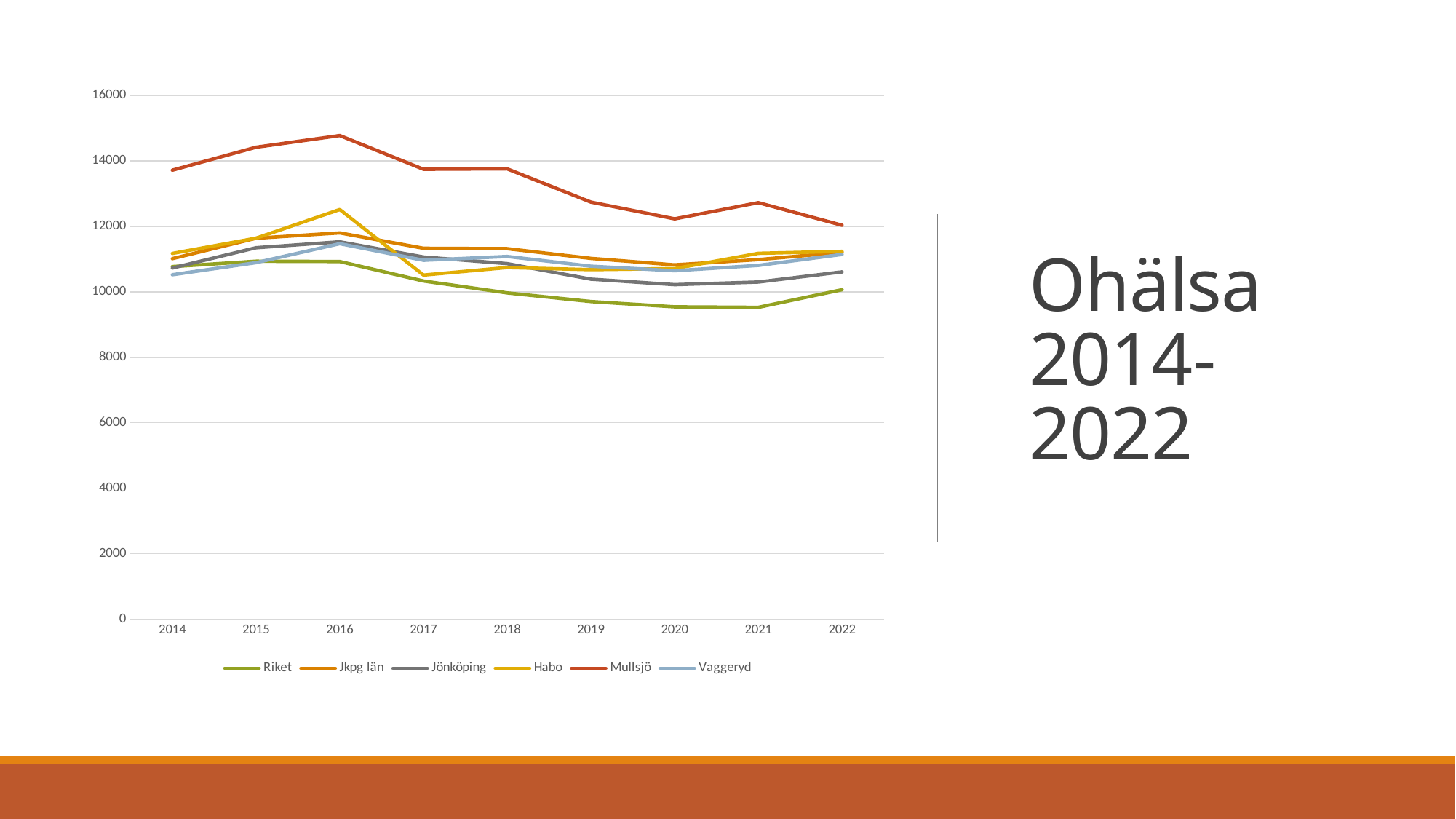
How many series does the legend list? 6 Which series has the lowest value in 2020? Riket Which series has the highest value in 2016? Mullsjö In which year does the Mullsjö line reach its highest value? 2016 Is the value for Habo in 2016 greater or less than 12000? greater What is the title shown next to the chart? Ohälsa 2014-2022 Does the Mullsjö line rise or fall from 2016 to 2020? fall Is the value for Riket in 2020 greater or less than 10000? less Is the value for Mullsjö in 2016 greater or less than 14000? greater How many years are plotted along the x axis? 9 What kind of chart is shown on the slide? line chart Which is larger in 2014, the value for Mullsjö or the value for Riket? Mullsjö